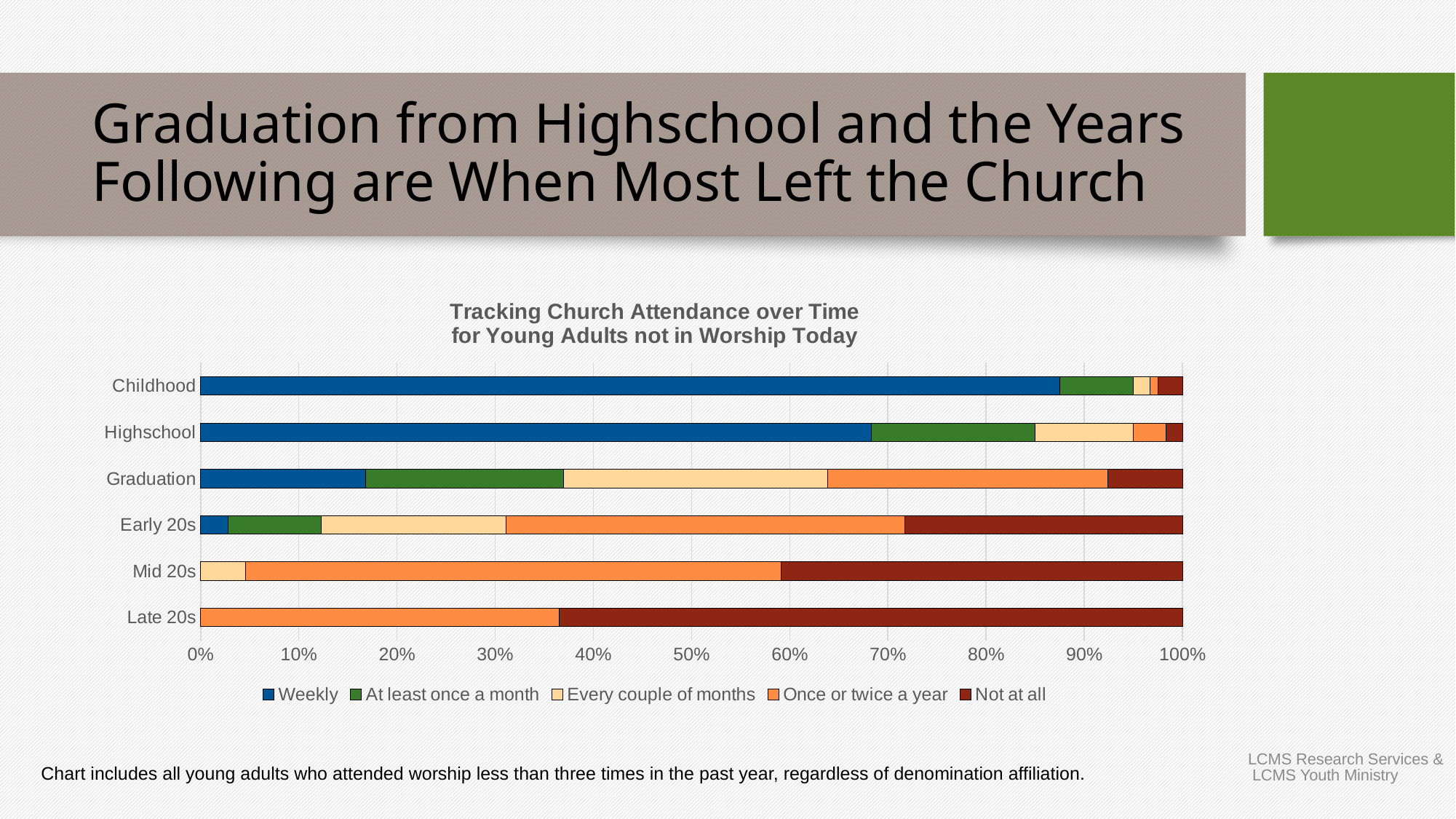
What is the title of the chart? Tracking Church Attendance over Time for Young Adults not in Worship Today How many categories (life stages) are plotted on the y axis of the chart? 6 Does the Weekly share rise or fall as the categories move from Childhood to Late 20s? Fall Which has a larger Weekly segment, Highschool or Early 20s? Highschool Is the Weekly share for Childhood greater or less than 80%? greater How many series does the chart's legend list? 5 Is the Weekly share for Graduation greater or less than 20%? less Which category has the largest Not at all segment? Late 20s Is the Not at all share for Late 20s greater or less than 50%? greater Which series is listed first in the chart's legend? Weekly What kind of chart is shown on the slide? Stacked bar chart Which category has the largest Weekly segment? Childhood